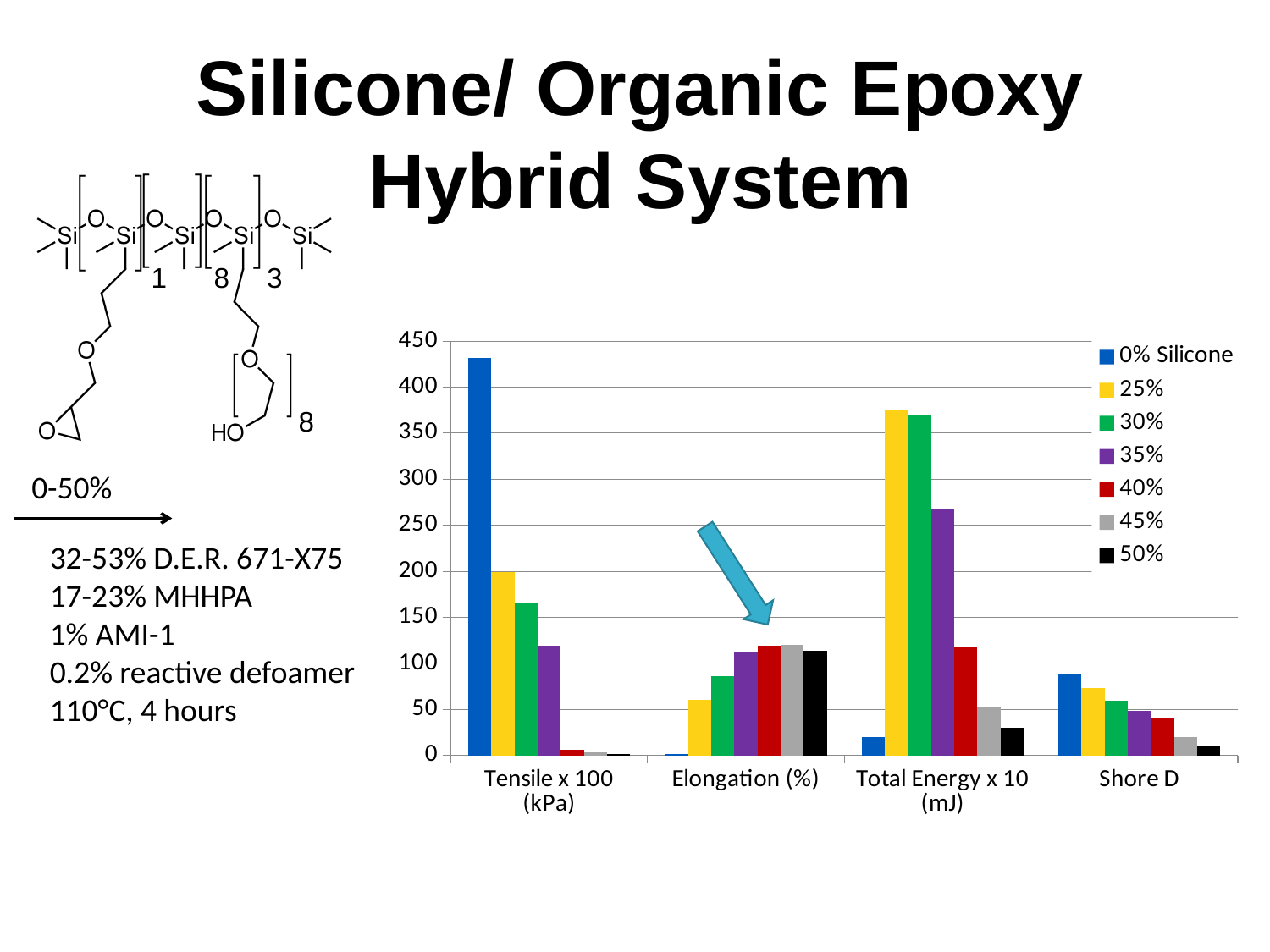
Which series has the lowest value in the Shore D category? 50% What is the first entry listed in the chart legend? 0% Silicone What kind of chart is shown on the slide? bar chart How many categories are shown along the x axis of the chart? 4 Is the value for 25% in the Total Energy x 10 (mJ) category greater or less than 350? greater Which series has the highest value in the Tensile x 100 (kPa) category? 0% Silicone Is the value for 35% in the Total Energy x 10 (mJ) category greater or less than 250? greater In the Tensile x 100 (kPa) category, which is larger: the value for 25% or the value for 30%? 25% How many series does the chart legend list? 7 Is the value for 0% Silicone in the Tensile x 100 (kPa) category greater or less than 400? greater In the Shore D category, do the values rise or fall as the silicone content increases from 0% to 50%? fall In the Total Energy x 10 (mJ) category, which is larger: the value for 35% or the value for 40%? 35%